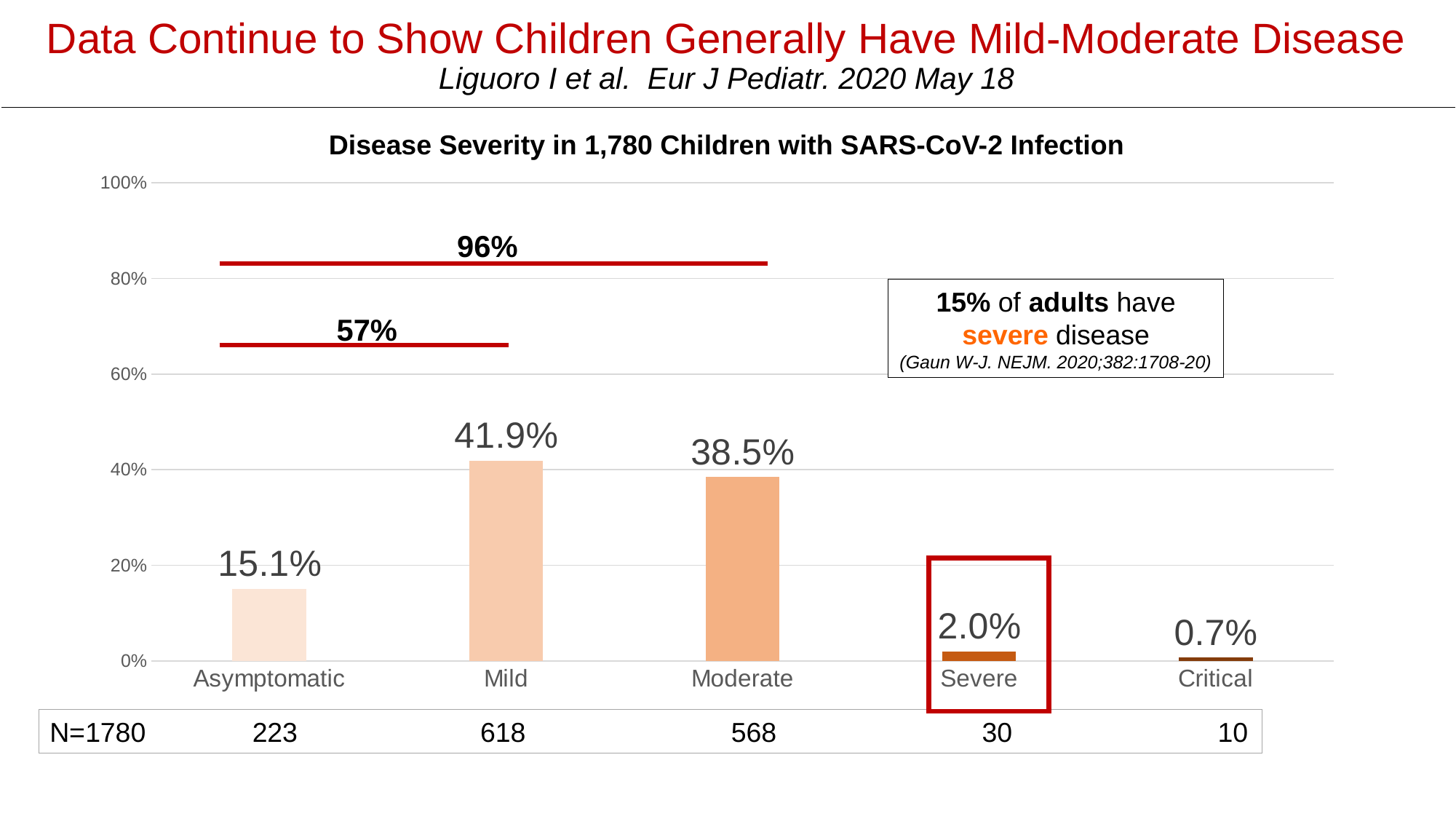
What percentage of children were classified as Mild? 41.9% What is the difference in percentage points between the Mild and Moderate categories? 3.4 How many severity categories are shown on the x axis? 5 What percentage of children were classified as Severe? 2.0% Which severity category has the highest percentage? Mild What is the title of the chart? Disease Severity in 1,780 Children with SARS-CoV-2 Infection Which severity category has the lowest percentage? Critical Is the value for Moderate greater or less than 40%? less What percentage of children were Asymptomatic? 15.1% How many children are in the Moderate category according to the table below the chart? 568 Which is larger, the percentage for Moderate or for Asymptomatic? Moderate What kind of chart is shown on the slide? Bar chart